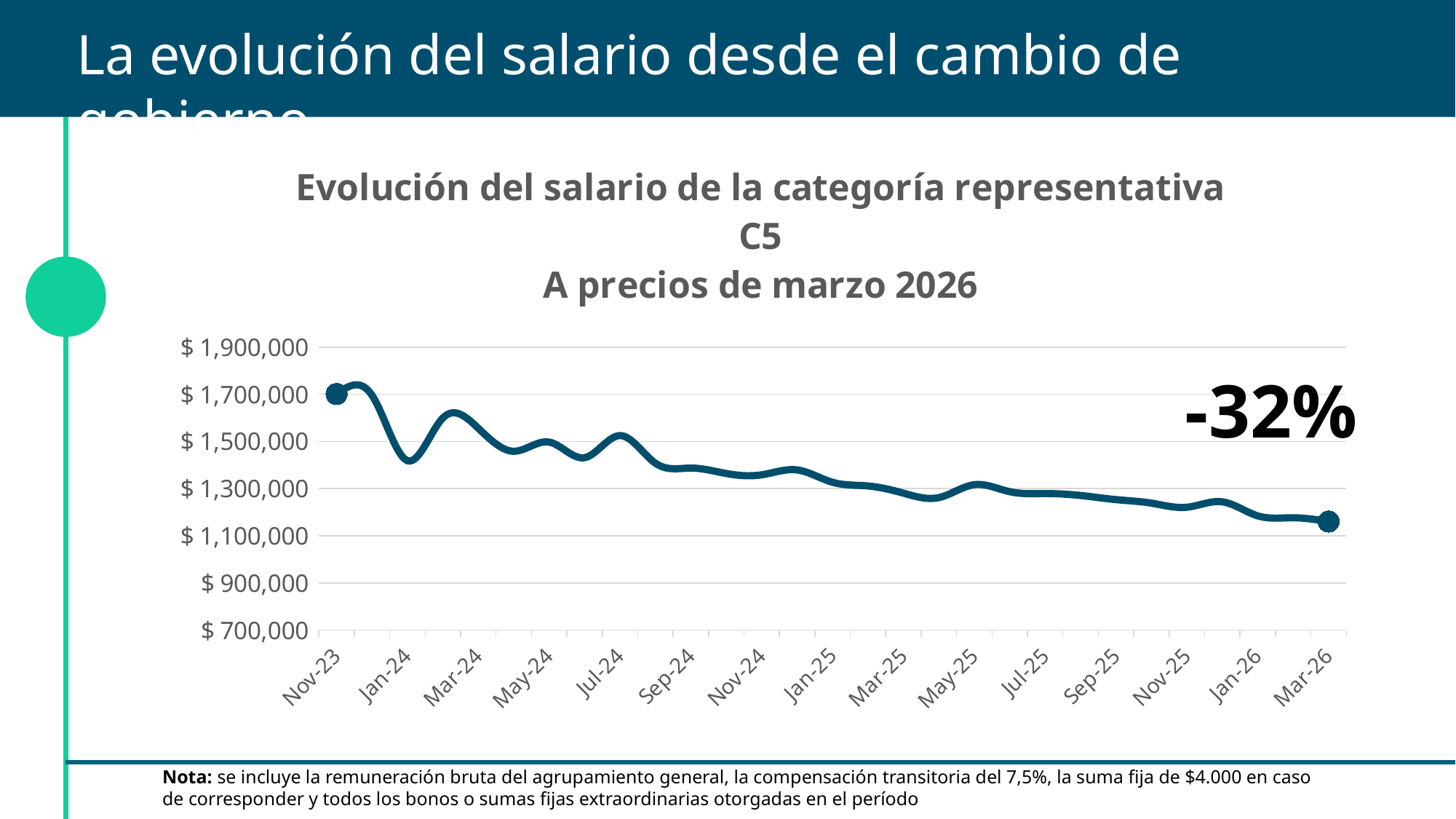
Is the value for Jan-24 greater or less than $ 1,500,000? less Is the value for Mar-26 greater or less than $ 1,300,000? less Which is larger, the value for Mar-24 or the value for Jan-24? Mar-24 Which month has the lowest value on the chart? Mar-26 Overall, do the values rise or fall from Nov-23 to Mar-26? fall What is the title of the chart? Evolución del salario de la categoría representativa C5 A precios de marzo 2026 Is the value for Nov-25 greater or less than $ 1,300,000? less What percentage change is annotated on the chart? -32% What kind of chart is shown on the slide? line chart Which is larger, the value for Nov-23 or the value for Mar-26? Nov-23